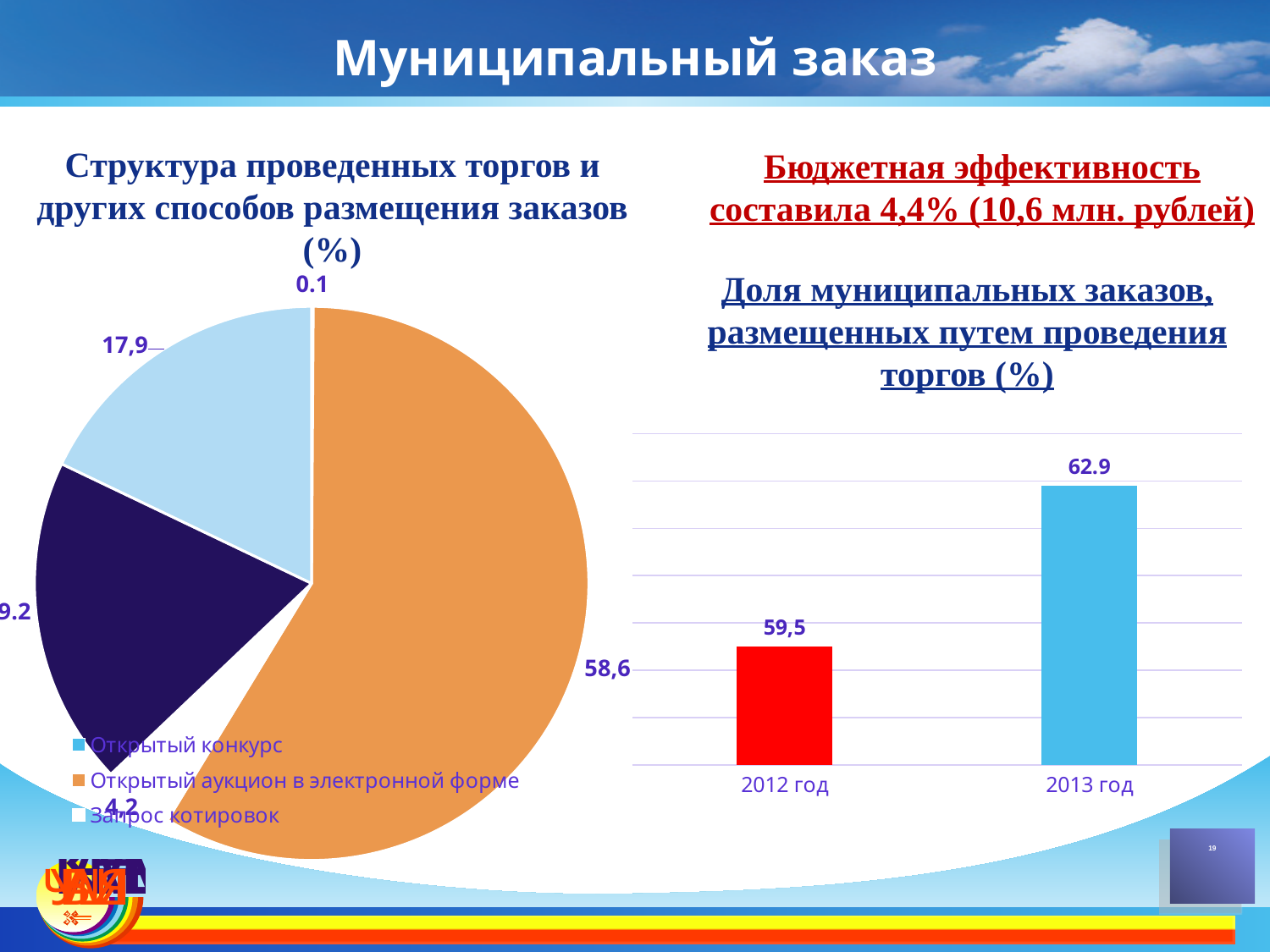
In the bar chart on the right, what is the difference between the 2013 год and 2012 год values? 3.4 In the bar chart on the right, what is the value for 2013 год? 62.9 In the bar chart on the right, which year has the higher value? 2013 год What kind of chart is shown on the right side of the slide? bar chart In the bar chart on the right, what colour is the bar for 2012 год? red In the bar chart on the right, does the value rise or fall from 2012 год to 2013 год? rise In the bar chart on the right, which year has the lower value? 2012 год In the pie chart on the left, what value is printed on the largest slice? 58,6 In the bar chart on the right, how many bars are plotted? 2 In the bar chart on the right, is the value for 2012 год larger or smaller than the value for 2013 год? smaller In the bar chart on the right, what is the value for 2012 год? 59,5 What kind of chart is shown on the left side of the slide? pie chart